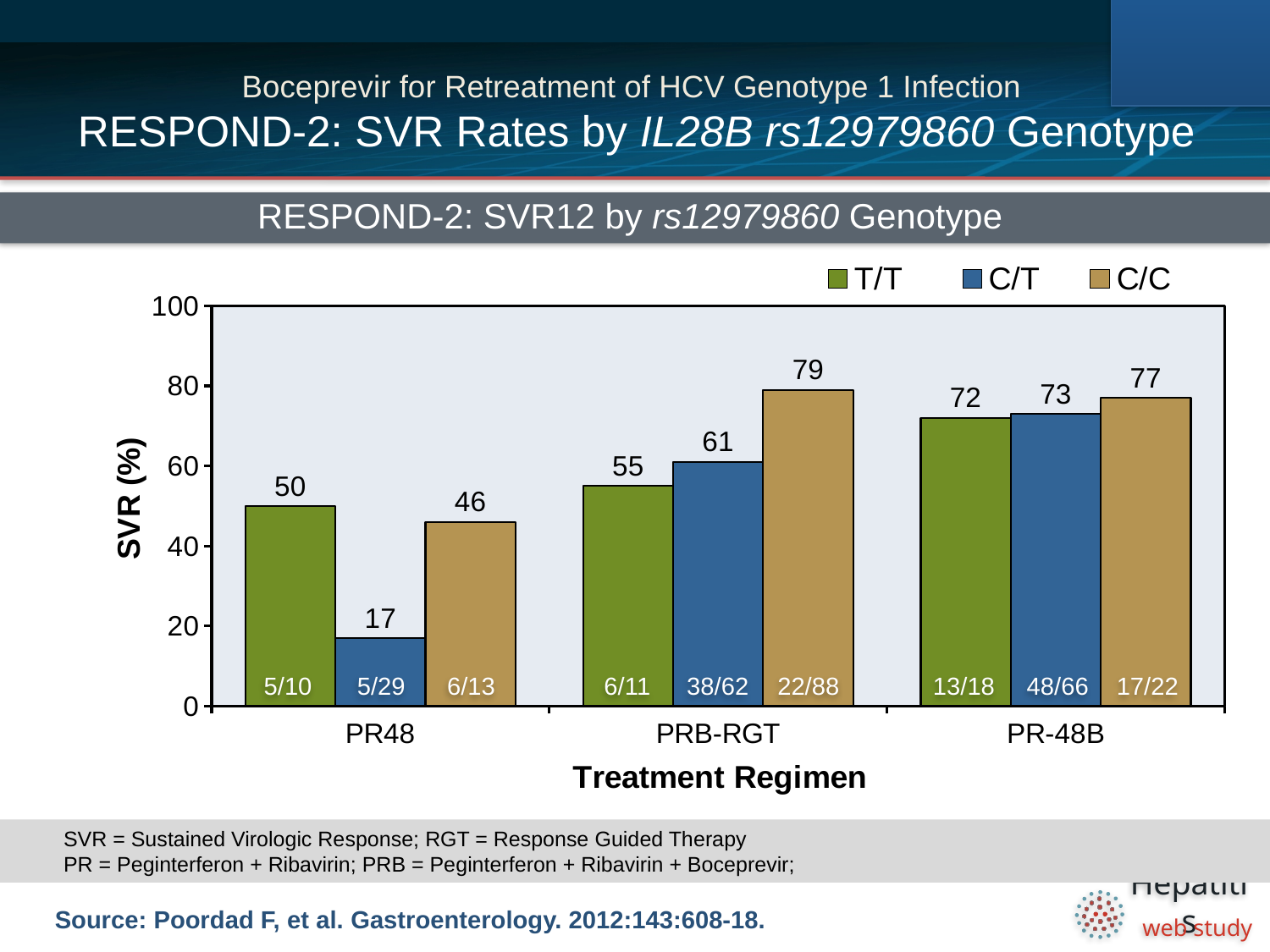
Which treatment regimen has the highest SVR (%) for the C/C genotype? PRB-RGT What kind of chart is shown on the slide? Bar chart Which is larger, the SVR (%) for T/T in PR48 or the SVR (%) for C/C in PR48? T/T in PR48 What is the difference in SVR (%) between the C/C and T/T genotypes in the PRB-RGT regimen? 24 What is the SVR (%) for the T/T genotype in the PR-48B regimen? 72 What is the label on the y axis of the chart? SVR (%) How many series does the legend list? 3 How many treatment regimens are shown on the x axis? 3 Which genotype has the lowest SVR (%) in the PR48 regimen? C/T What is the SVR (%) for the C/C genotype in the PRB-RGT regimen? 79 Does the SVR (%) for the C/T genotype rise or fall from PR48 to PR-48B? Rise What is the SVR (%) for the C/T genotype in the PR48 regimen? 17